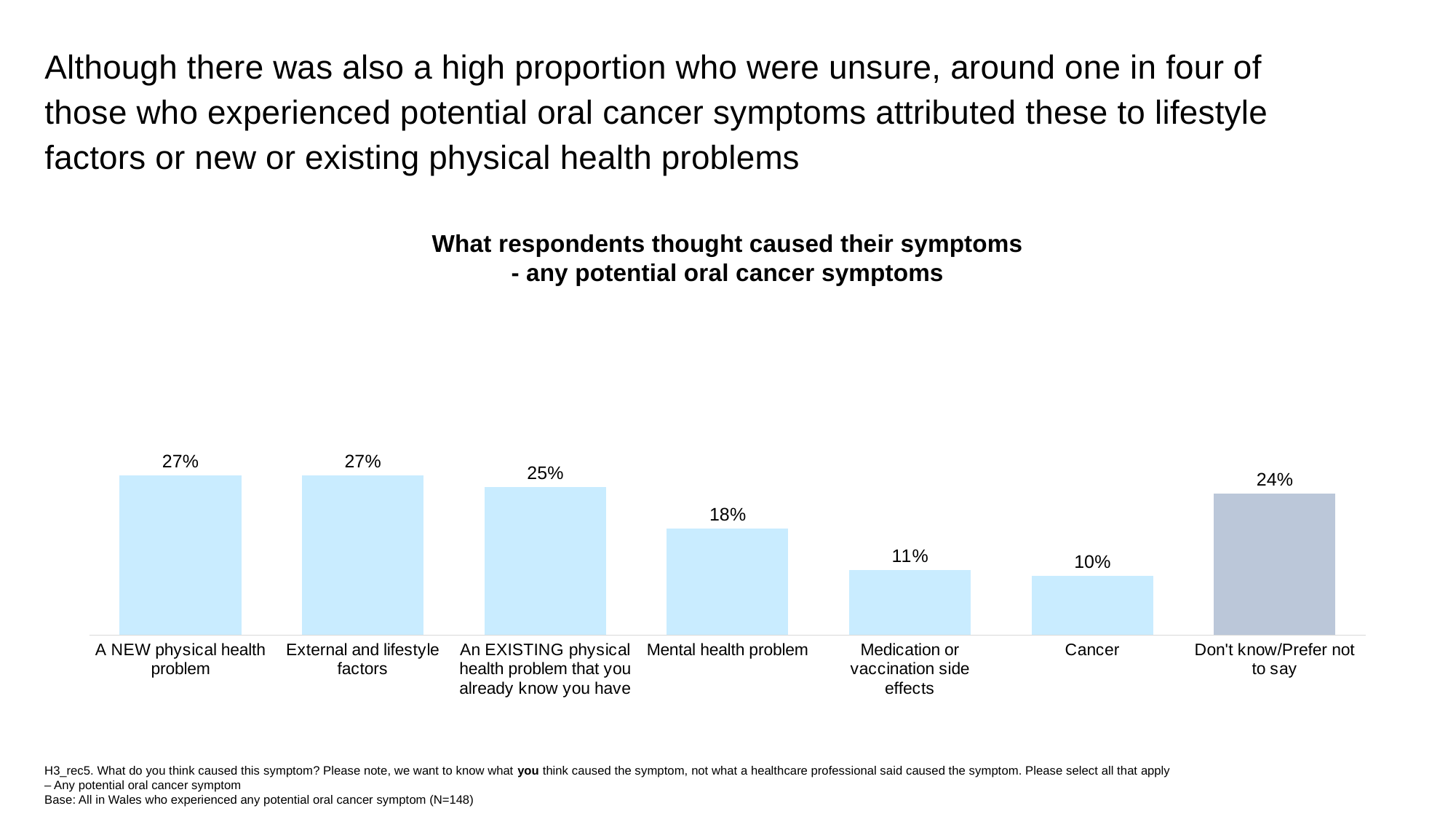
What percentage of respondents attributed their symptoms to a mental health problem? 18% What percentage of respondents answered Don't know/Prefer not to say? 24% What kind of chart is shown on the slide? Bar chart Which bar is shown in a different colour (grey) from the others? Don't know/Prefer not to say How many categories are shown in the chart? 7 What is the difference between Mental health problem and Medication or vaccination side effects? 7 percentage points Which category has the lowest value? Cancer What is the difference between the value for A NEW physical health problem and the value for Cancer? 17 percentage points What is the value for Cancer? 10% Which is larger: the value for An EXISTING physical health problem that you already know you have or the value for Don't know/Prefer not to say? An EXISTING physical health problem that you already know you have What is the title of the chart? What respondents thought caused their symptoms - any potential oral cancer symptoms What is the value for Medication or vaccination side effects? 11%